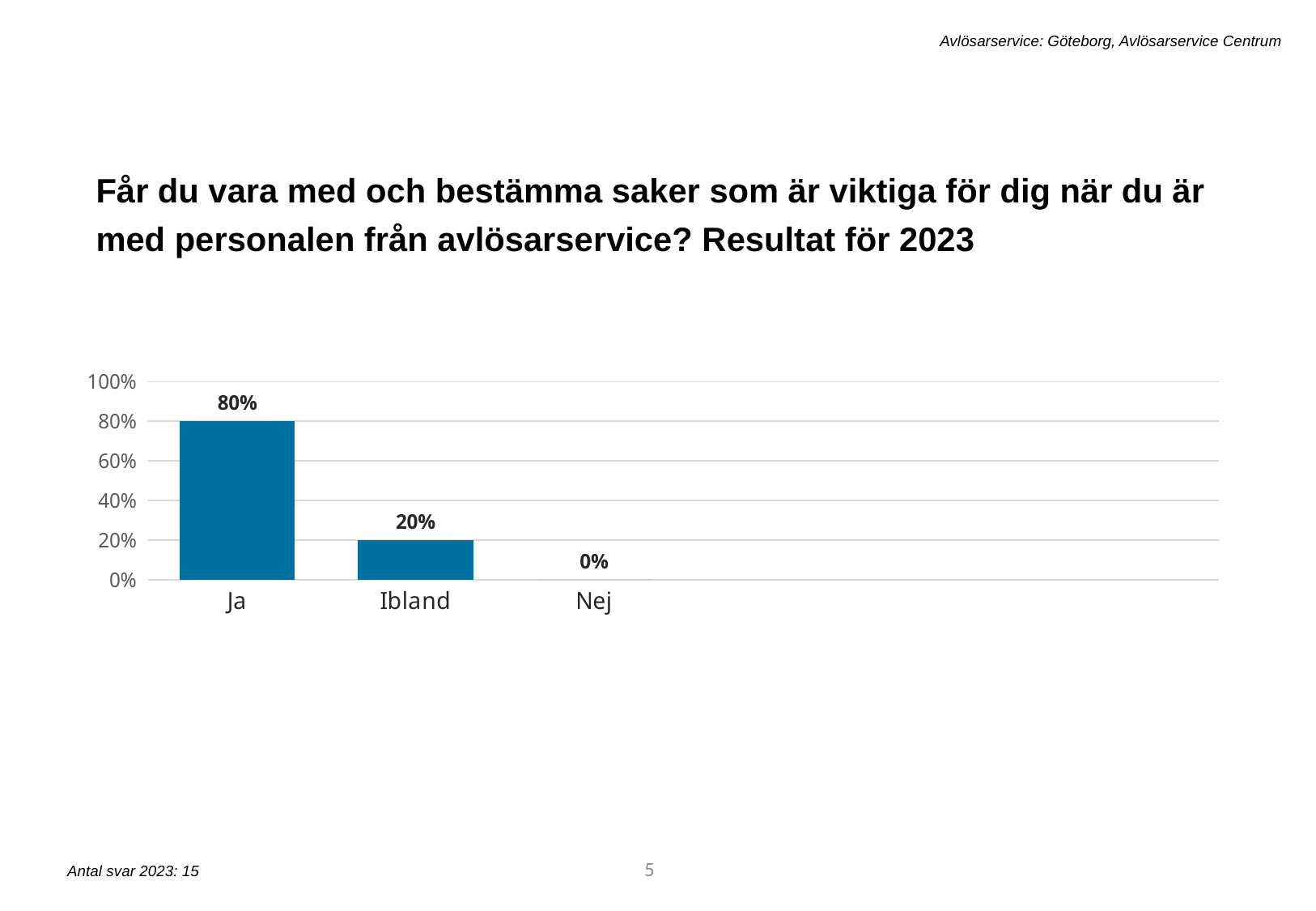
Which is larger, the value for Ibland or the value for Nej? Ibland What is the value for Ibland? 20% What is the value for Nej? 0% What is the value for Ja? 80% What is the number of responses (Antal svar) for 2023 stated on the slide? 15 Is the value for Ja greater or less than 60%? greater Do the values rise or fall from Ja to Nej along the x axis? fall What is the difference between the values for Ja and Ibland? 60% How many categories are shown on the x axis? 3 What kind of chart is shown on the slide? bar chart Which category has the lowest value? Nej Which category has the highest value? Ja